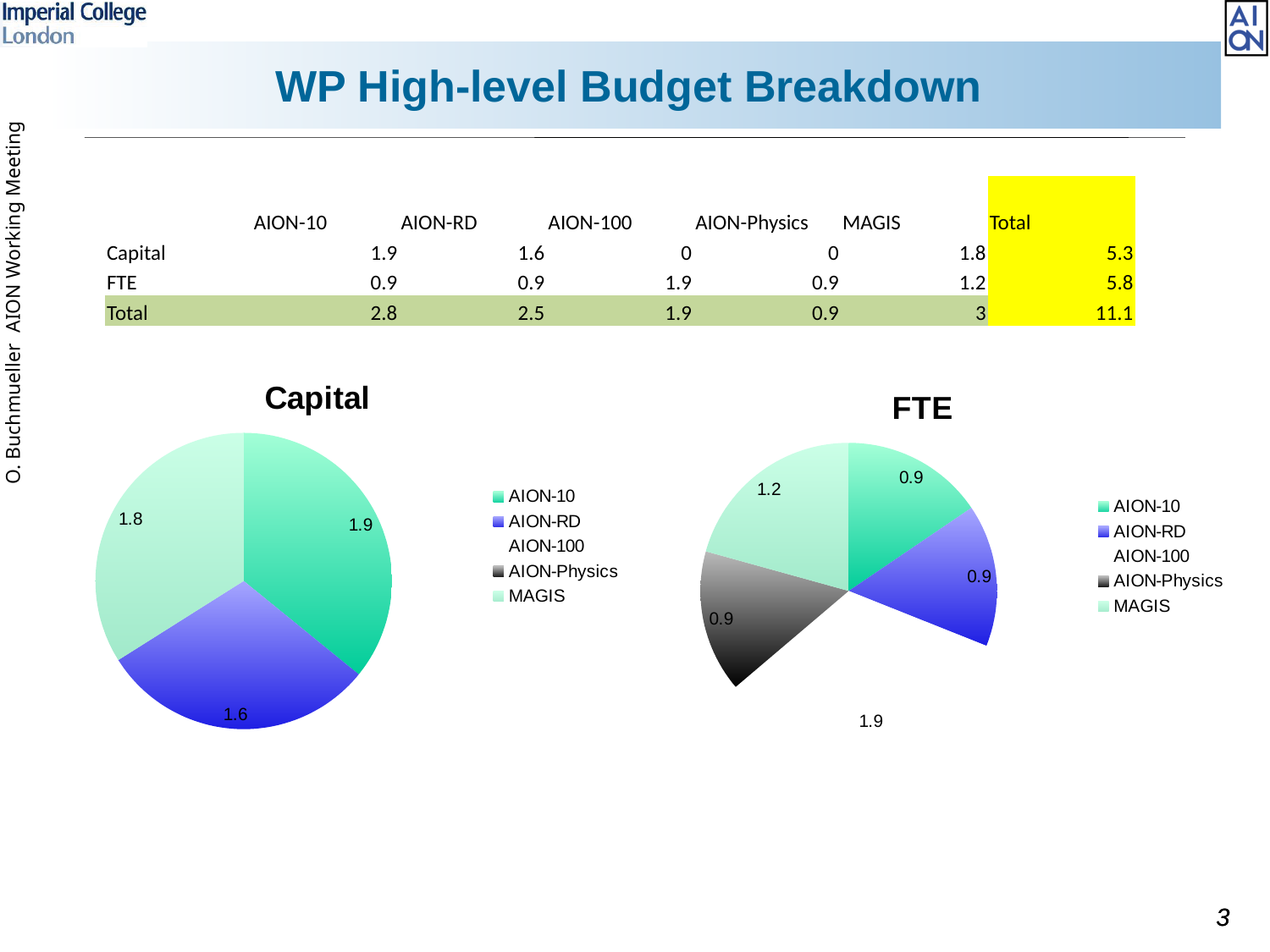
In the FTE chart, what is the value for AION-100? 1.9 In the Capital chart, which category has the largest slice? AION-10 In the Capital chart, what is the difference between the AION-10 and AION-RD values? 0.3 In the FTE chart, what is the value for MAGIS? 1.2 In the FTE chart, which category has the largest slice? AION-100 In the FTE chart, what is the difference between the AION-100 and MAGIS values? 0.7 In the Capital chart, what is the value for AION-RD? 1.6 How many entries does the legend of the Capital chart list? 5 What kind of chart is the Capital chart? pie chart In the Capital chart, what is the value for MAGIS? 1.8 In the Capital chart, what is the value for AION-10? 1.9 In the FTE chart, which is larger, the value for AION-100 or the value for AION-Physics? AION-100